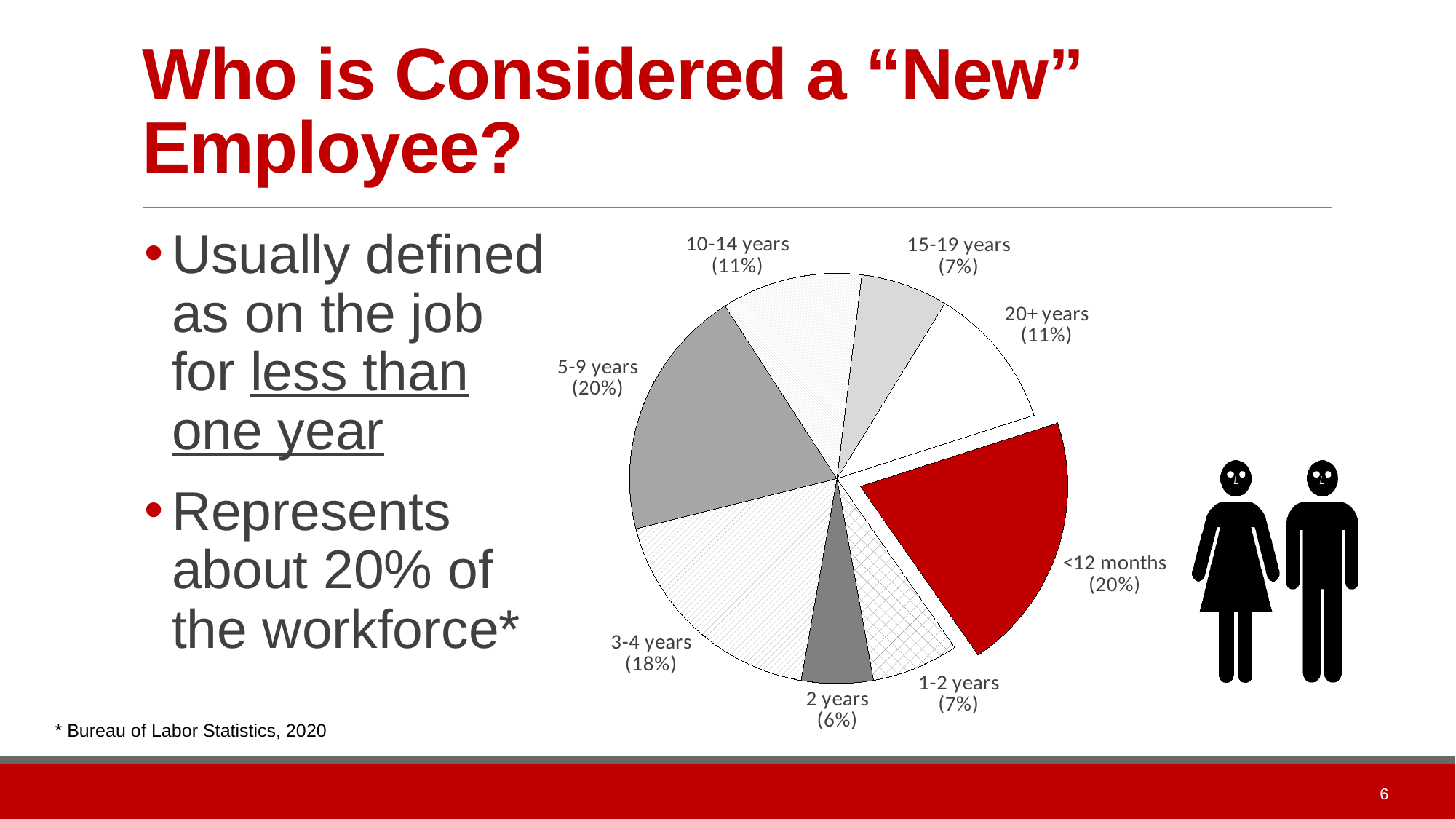
What percentage of the workforce has been on the job for less than 12 months? 20% What kind of chart is shown on the slide? pie chart Which slice of the pie chart is coloured red? <12 months Which is larger, the 3-4 years slice or the 10-14 years slice? 3-4 years What is the difference in percentage points between the 5-9 years slice and the 1-2 years slice? 13% What is the value shown for the 20+ years slice? 11% How many slices does the pie chart have? 8 Which slice of the pie chart is the smallest? 2 years What is the difference in percentage points between the 3-4 years slice and the 2 years slice? 12% Which slice of the pie chart is pulled out (exploded) from the rest? <12 months What is the value shown for the 15-19 years slice? 7% What is the value shown for the 3-4 years slice? 18%